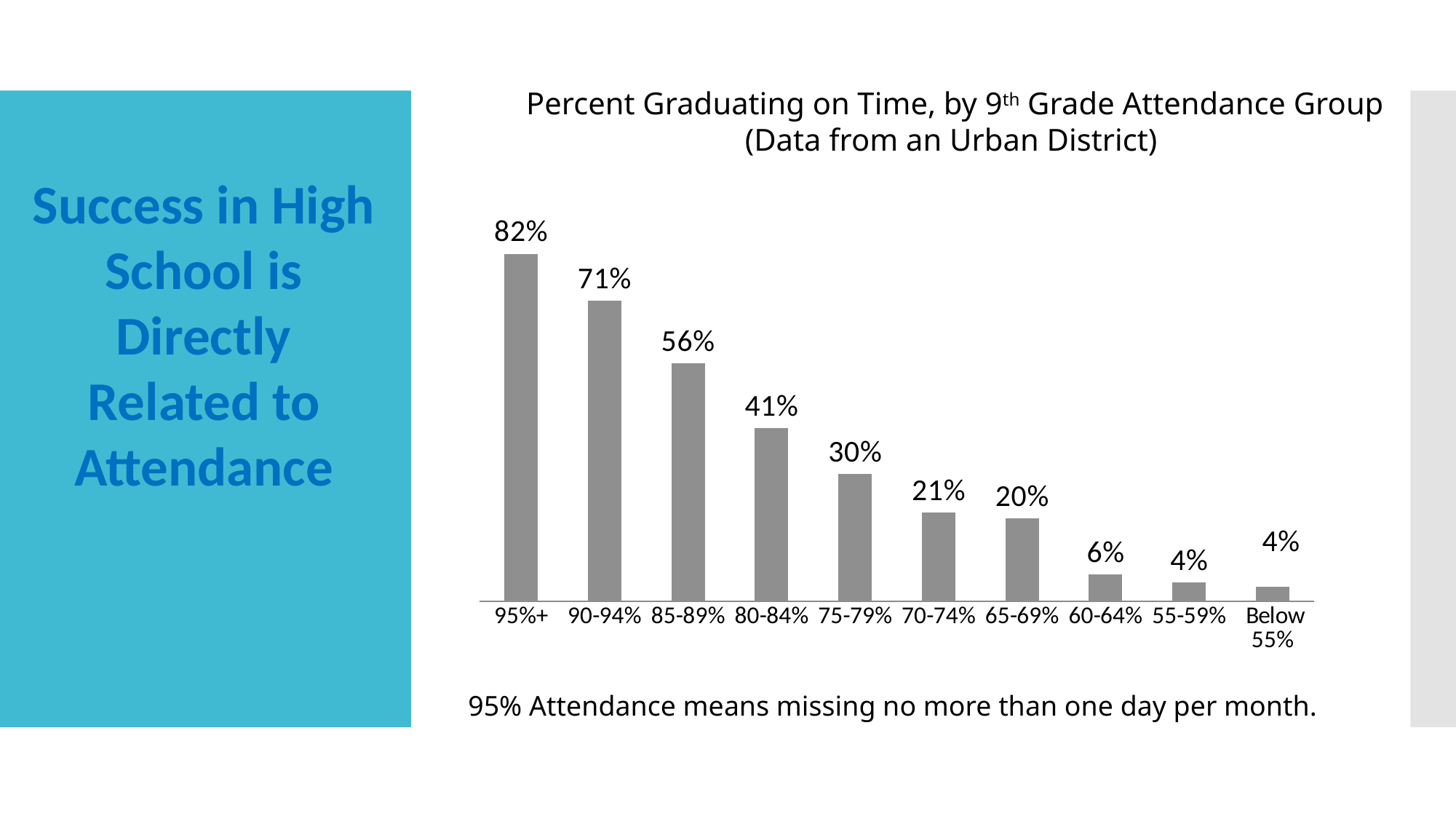
What is the value shown for the 80-84% attendance group? 41% Which attendance group has the highest percent graduating on time? 95%+ What kind of chart is shown on the slide? Bar chart What is the title of the chart? Percent Graduating on Time, by 9th Grade Attendance Group (Data from an Urban District) What is the difference between the values for the 95%+ and Below 55% attendance groups? 78% Which has a higher value, the 75-79% group or the 70-74% group? 75-79% What is the value shown for the 60-64% attendance group? 6% What is the difference between the values for the 90-94% and 85-89% attendance groups? 15% How many attendance groups are shown on the chart? 10 Do the values rise or fall moving from left to right along the x axis? Fall What is the value shown for the 65-69% attendance group? 20% What percent of students in the 95%+ attendance group graduated on time? 82%